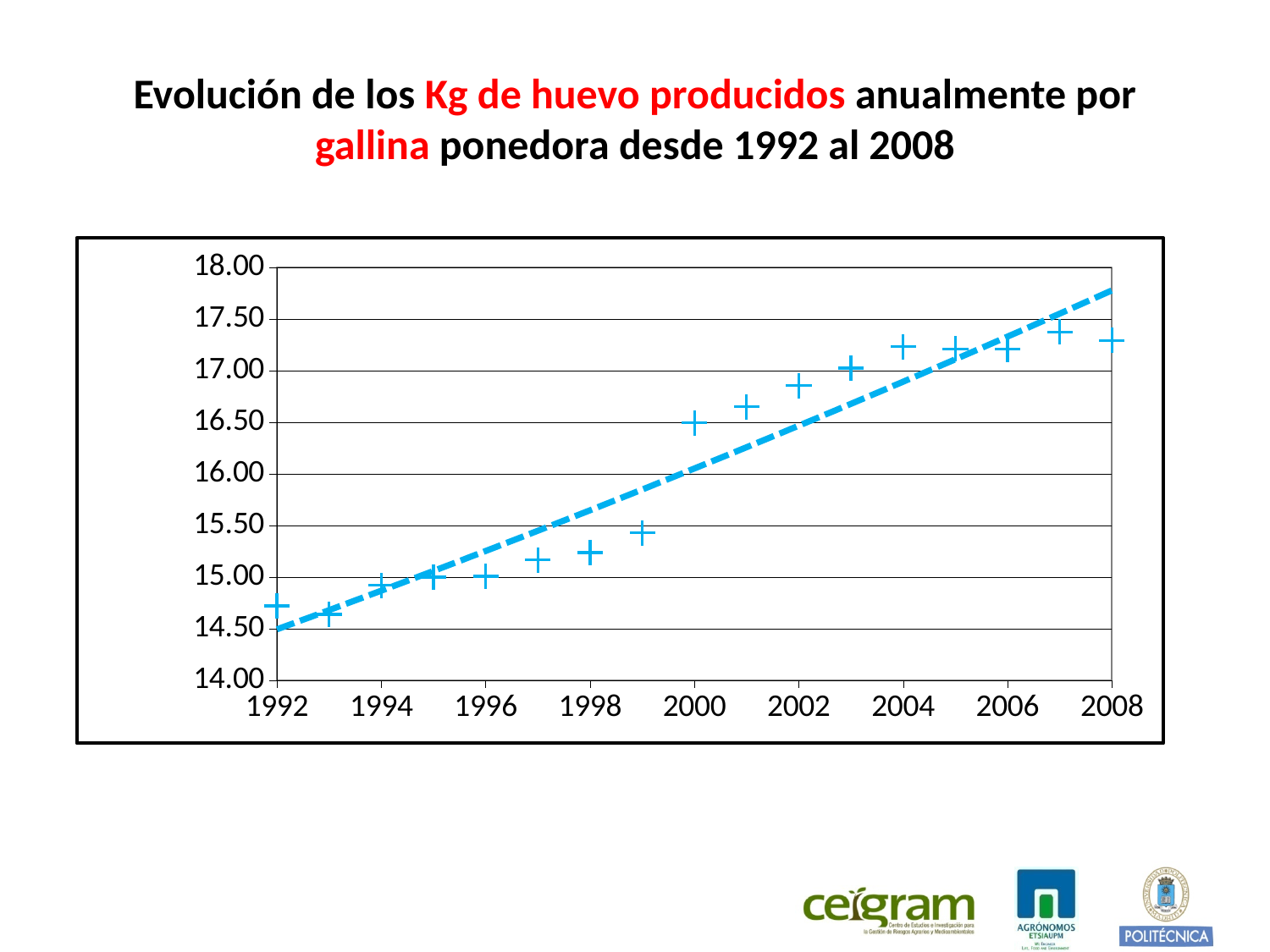
Is the value for 2000 greater or less than 16.00? greater Which year has the larger value, 1999 or 2000? 2000 Is the value for 1996 greater or less than 15.50? less Is the value for 2008 greater or less than 17.00? greater What is the highest value shown on the y axis? 18.00 How many data points are plotted on the chart? 17 What is the first year shown on the x axis? 1992 Do the values generally rise or fall from 1992 to 2008? rise What kind of chart is shown on the slide? scatter chart Which year has the larger value, 1992 or 2008? 2008